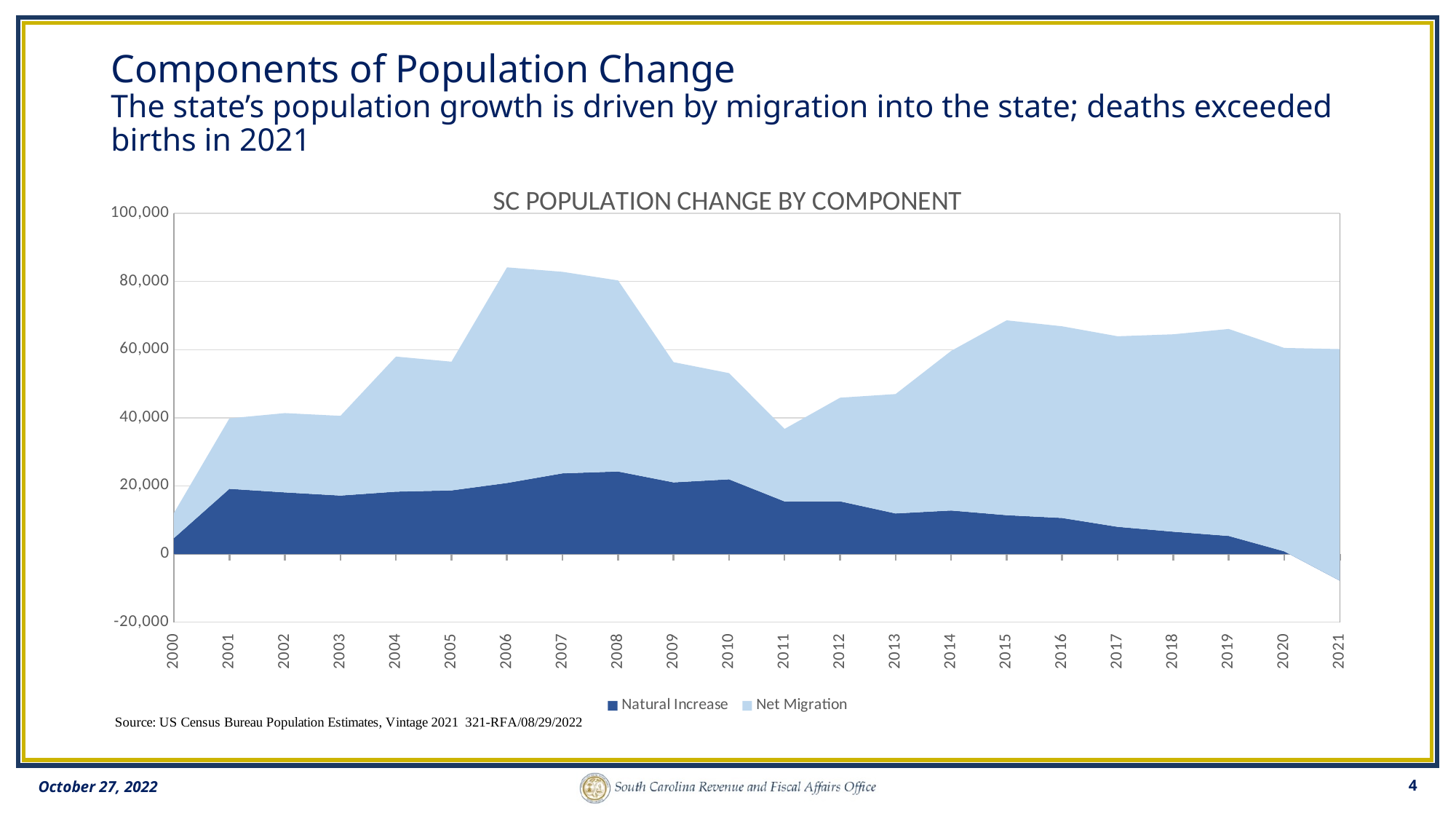
In which year is the Natural Increase value lowest? 2021 Is the Natural Increase value for 2008 greater or less than 20,000? greater What is the title of the chart? SC POPULATION CHANGE BY COMPONENT Does the Natural Increase value rise or fall from 2008 to 2021? Fall Is the Natural Increase value for 2021 greater or less than 0? less How many years are plotted along the x axis? 22 What kind of chart is shown on the slide? Area chart How many series does the legend list? 2 In which year is the combined total of the two components lowest? 2000 Is the combined total of Natural Increase and Net Migration for 2011 greater or less than 40,000? less Which series is shown in the darker blue colour? Natural Increase